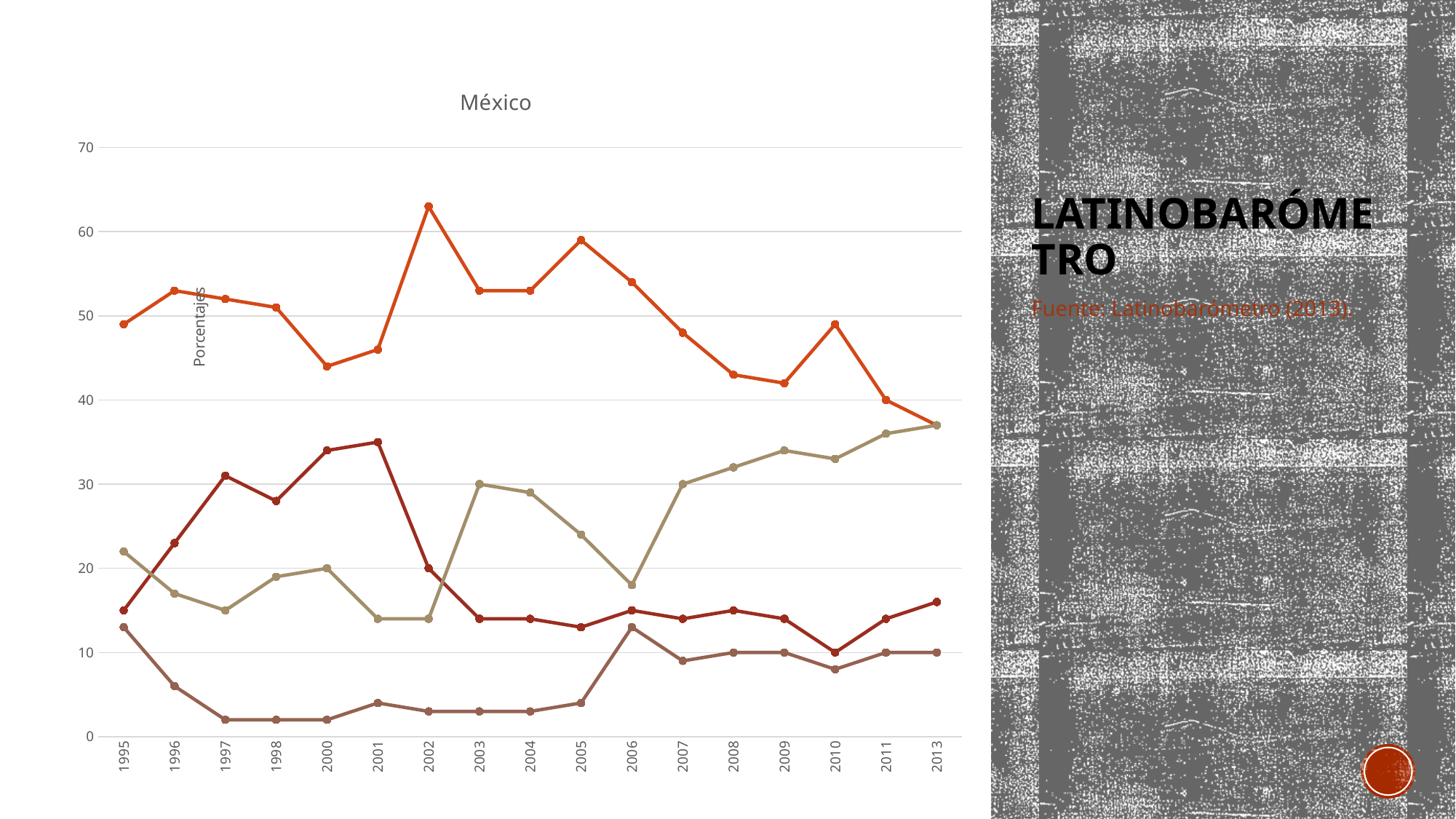
Is the value of the dark red line in 2001 greater or less than 30? greater How many lines are plotted on the chart? 4 How many years are shown along the x axis of the chart? 17 Is the value of the orange (top) line in 2000 greater or less than 50? less What kind of chart is shown on the slide? line chart What is the title of the chart? México Does the tan line rise or fall between 2006 and 2013? rise What is the label on the vertical axis of the chart? Porcentajes In which year does the orange (top) line reach its highest value? 2002 Is the value of the orange (top) line in 2002 greater or less than 60? greater Does the orange (top) line rise or fall between 2005 and 2009? fall